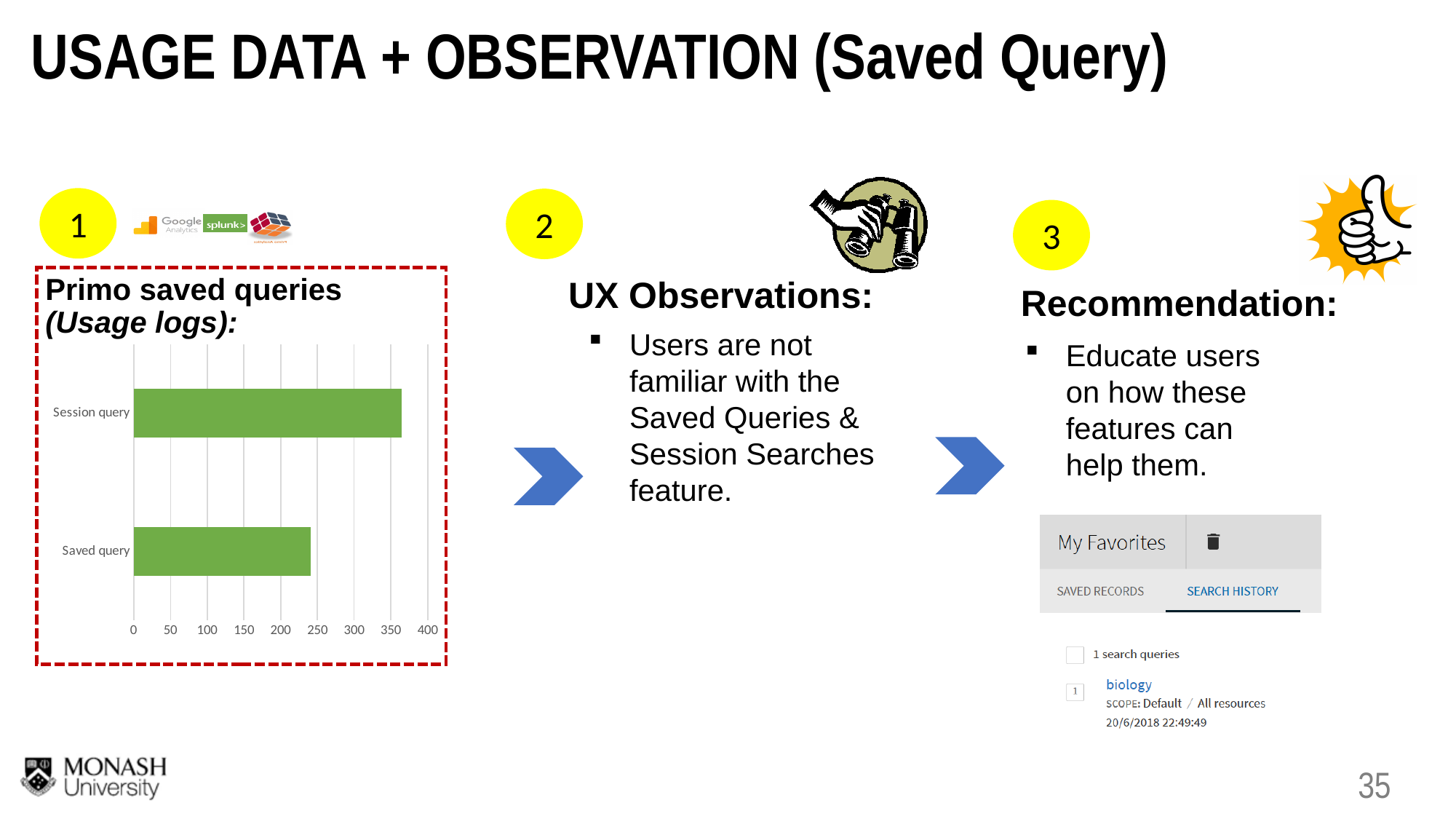
Is the value for Session query greater or less than 400? less Which is larger in the bar chart, Session query or Saved query? Session query Which category has the lowest value in the bar chart? Saved query What is the maximum value shown on the x axis of the bar chart? 400 What colour are the bars in the bar chart? green Which category has the highest value in the bar chart? Session query How many categories does the bar chart show? 2 What kind of chart is shown under 'Primo saved queries (Usage logs)'? bar chart Is the value for Session query greater or less than 300? greater Is the value for Saved query greater or less than 200? greater